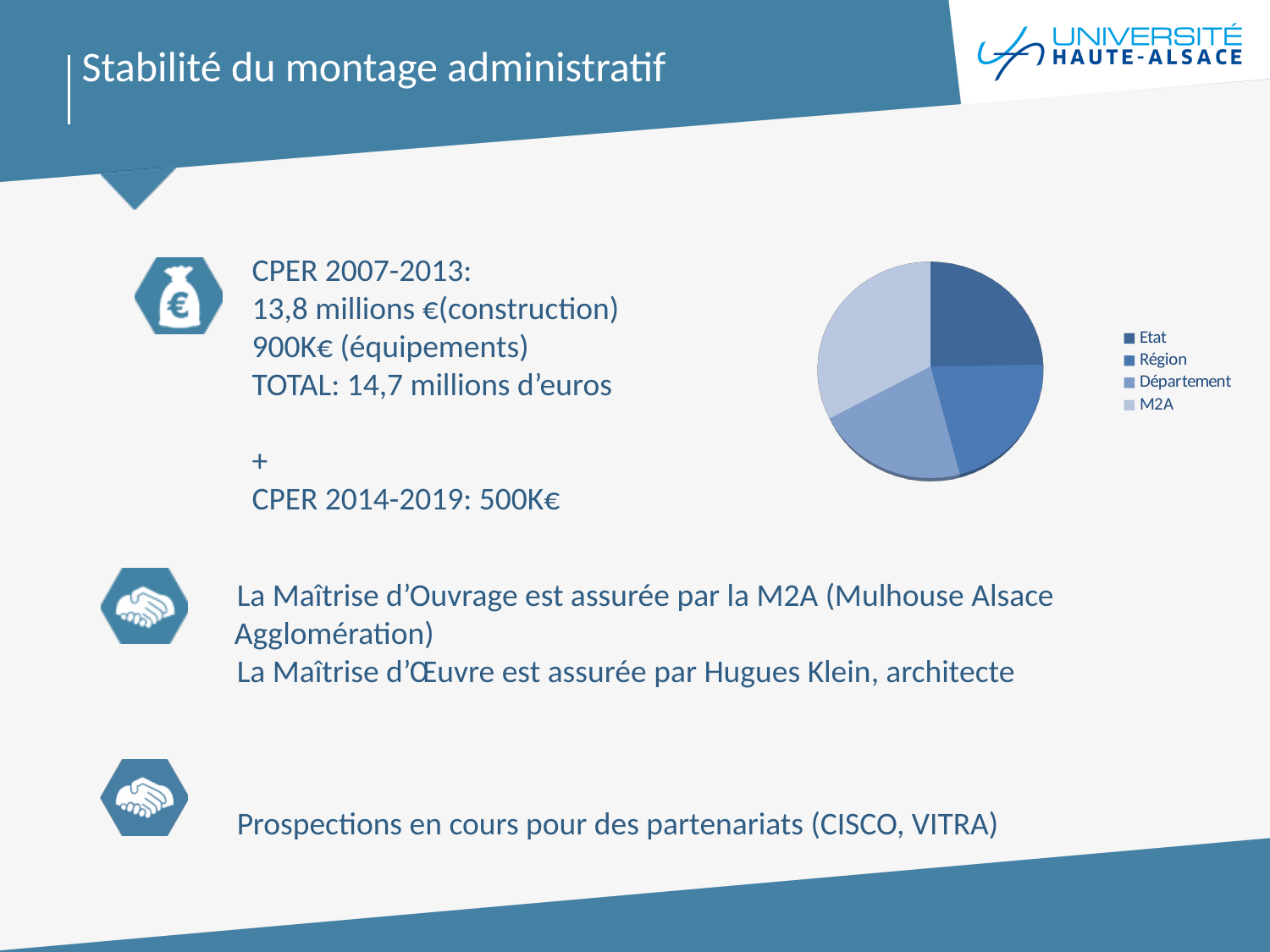
Which legend entry of the pie chart is shown in the darkest blue? Etat What kind of chart is shown on the slide? pie chart Which slice is larger in the pie chart, M2A or Etat? M2A Which category has the largest slice in the pie chart? M2A Which slice is larger in the pie chart, M2A or Région? M2A How many slices does the pie chart have? 4 What are the four categories listed in the legend of the pie chart? Etat, Région, Département, M2A How many entries does the legend of the pie chart list? 4